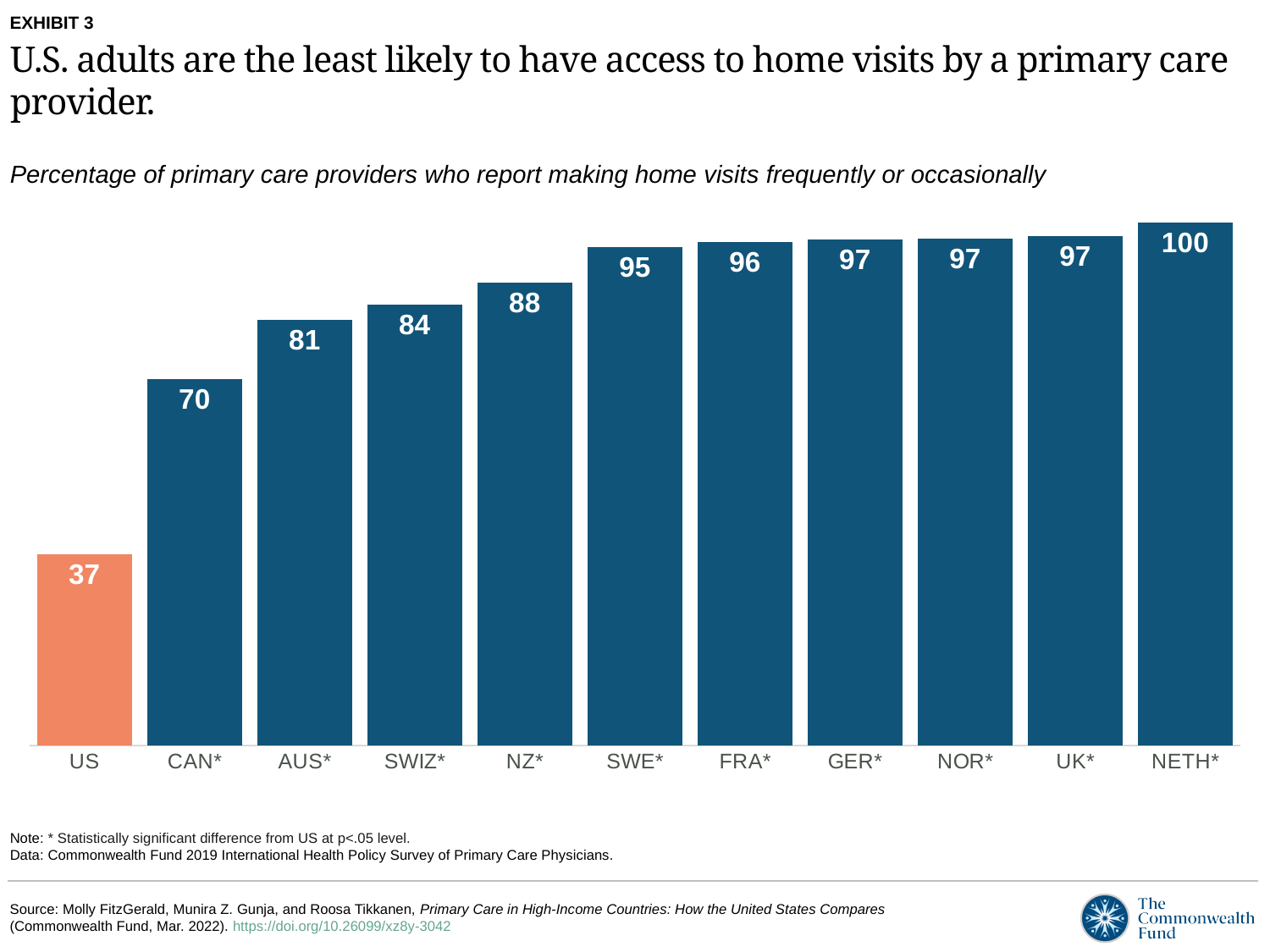
What is the value for SWIZ*? 84 How many countries are shown in the chart? 11 What is the difference between the values for NETH* and US? 63 Which country has the highest value? NETH* Which bar is shown in a different colour from the others? US What is the value for NZ*? 88 Do the values rise or fall from left to right along the x axis? rise Which country has the lowest value? US What is the difference between the values for CAN* and AUS*? 11 What kind of chart is this? bar chart What is the value for US? 37 Which is larger, the value for SWE* or the value for NZ*? SWE*